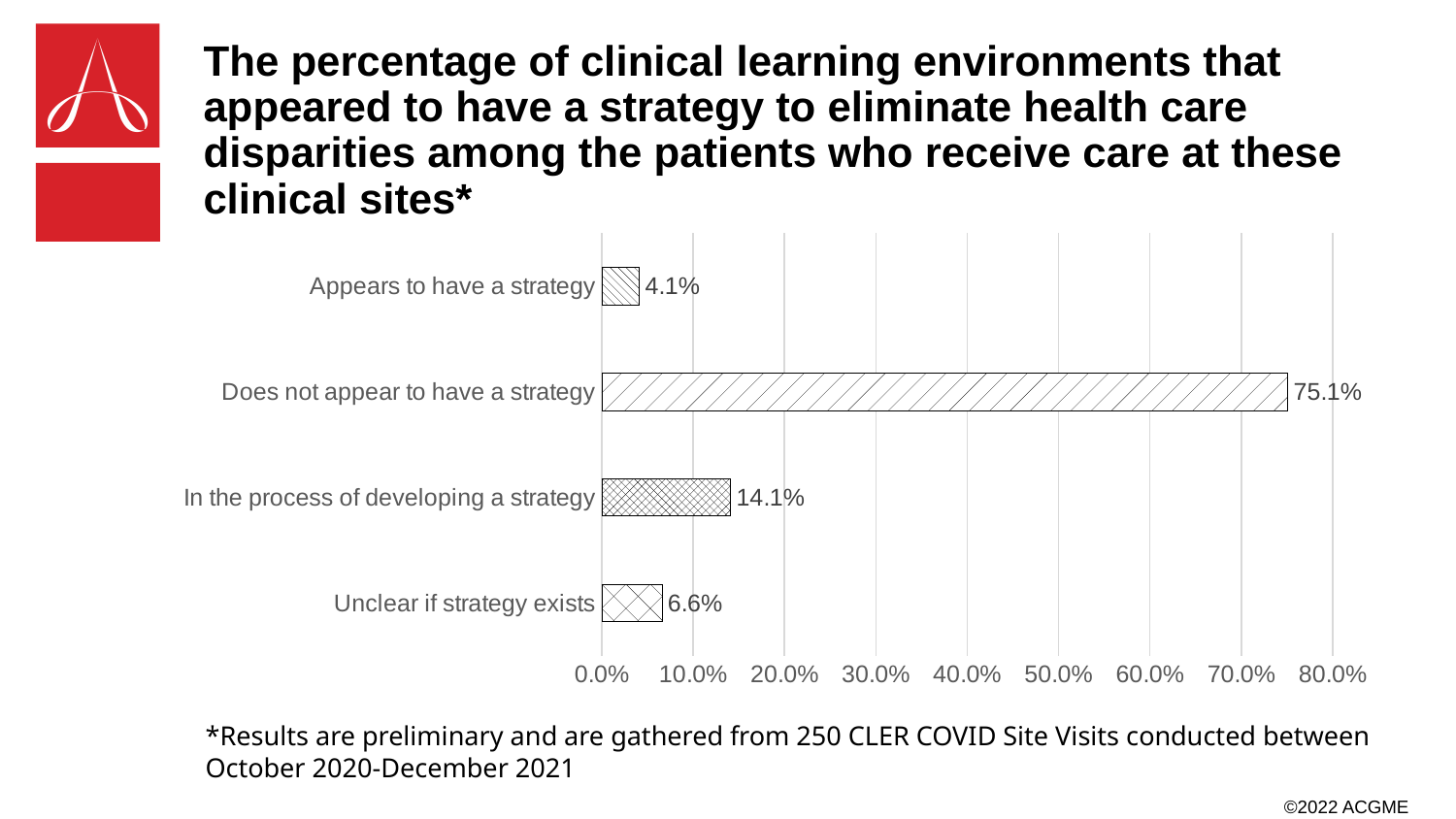
What percentage of clinical learning environments appeared to have a strategy? 4.1% What percentage of clinical learning environments did not appear to have a strategy? 75.1% Which is larger: 'In the process of developing a strategy' or 'Unclear if strategy exists'? In the process of developing a strategy Which category has the lowest percentage? Appears to have a strategy What is the difference between 'Does not appear to have a strategy' and 'In the process of developing a strategy'? 61.0% What is the value for 'Unclear if strategy exists'? 6.6% What is the difference between 'Unclear if strategy exists' and 'Appears to have a strategy'? 2.5% What is the maximum value shown on the x axis? 80.0% Which category has the highest percentage? Does not appear to have a strategy What kind of chart is shown on the slide? Bar chart What percentage of clinical learning environments were in the process of developing a strategy? 14.1% How many categories are shown in the chart? 4